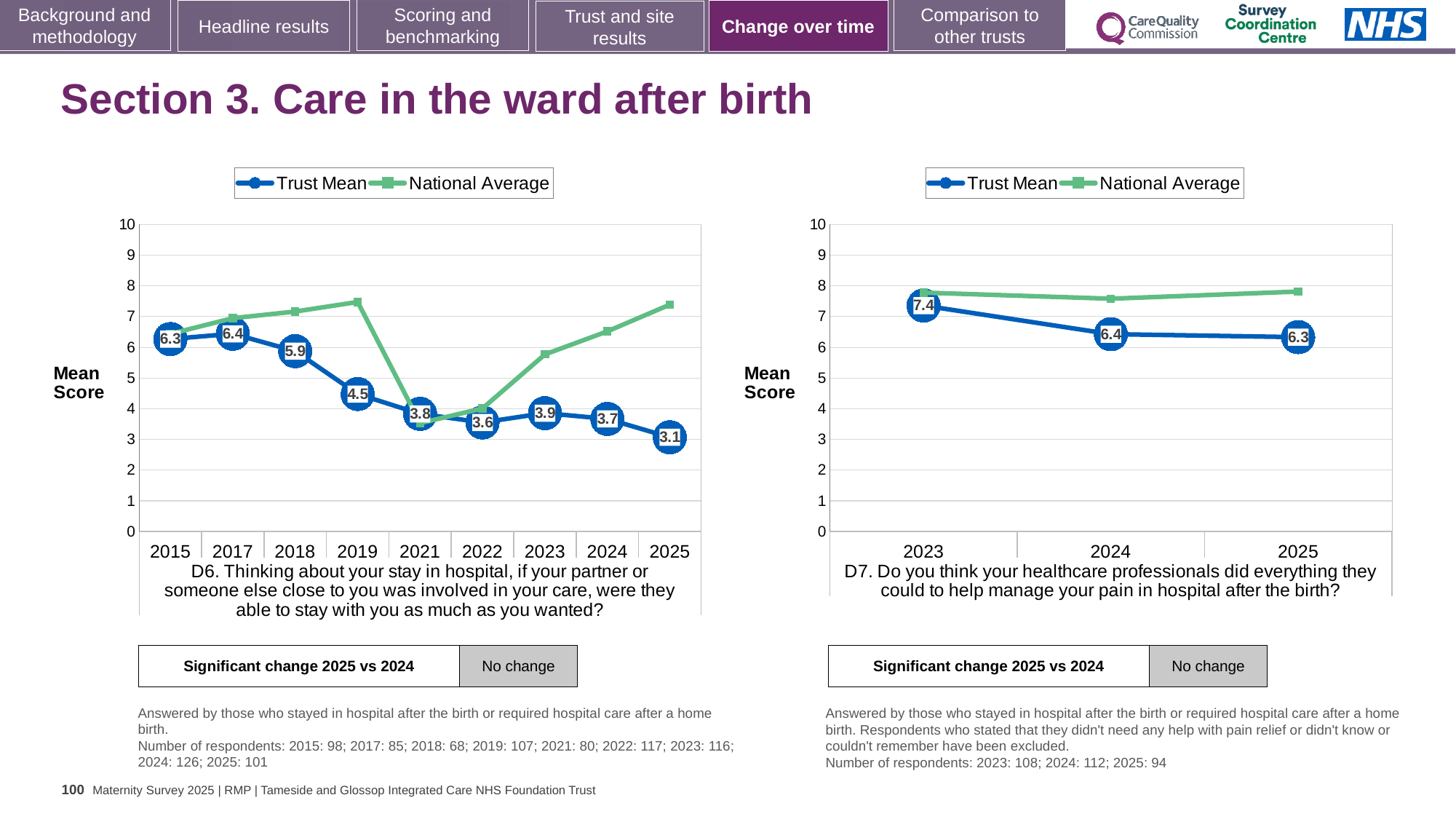
How many series does the legend of the D7 chart on the right list? 2 In the D7 chart on the right, is the Trust Mean higher in 2023 or in 2025? 2023 In the D6 chart on the left, is the National Average for 2025 greater or less than 7? greater In the D7 chart on the right, what is the difference between the Trust Mean in 2023 and in 2024? 1.0 In the D7 chart on the right, what is the Trust Mean for 2023? 7.4 In the D6 chart on the left, how many years are shown on the x axis? 9 In the D6 chart on the left, what is the Trust Mean for 2019? 4.5 In the D6 chart on the left, what is the difference between the Trust Mean in 2015 and in 2025? 3.2 In the D6 chart on the left, what is the Trust Mean for 2025? 3.1 In the D6 chart on the left, which year has the lowest Trust Mean? 2025 In the D7 chart on the right, does the Trust Mean rise or fall from 2023 to 2025? fall In the D6 chart on the left, which year has the highest Trust Mean? 2017